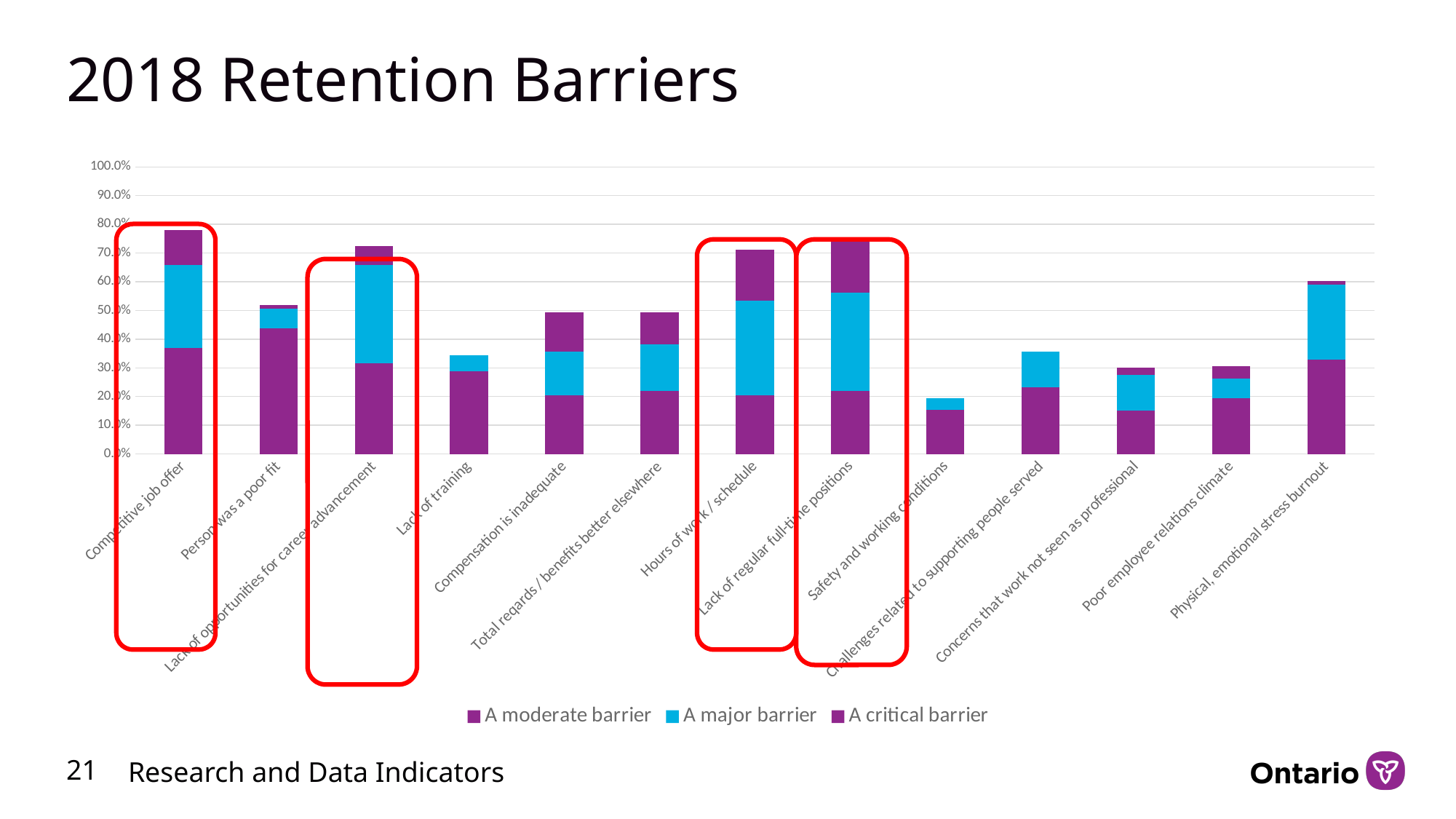
Which has the taller total bar: Competitive job offer or Lack of training? Competitive job offer Is the total bar for Lack of training greater or less than 40%? less What kind of chart is shown on the slide? Stacked bar chart What is the title of the chart? 2018 Retention Barriers Is the total bar for Lack of regular full-time positions greater or less than 70%? greater How many categories (barriers) are plotted on the x axis? 13 How many series does the legend list? 3 Is the total bar for Safety and working conditions greater or less than 30%? less Which barrier has the lowest total bar? Safety and working conditions Which has the taller total bar: Hours of work / schedule or Compensation is inadequate? Hours of work / schedule How many bars are highlighted with red outlines on the chart? 4